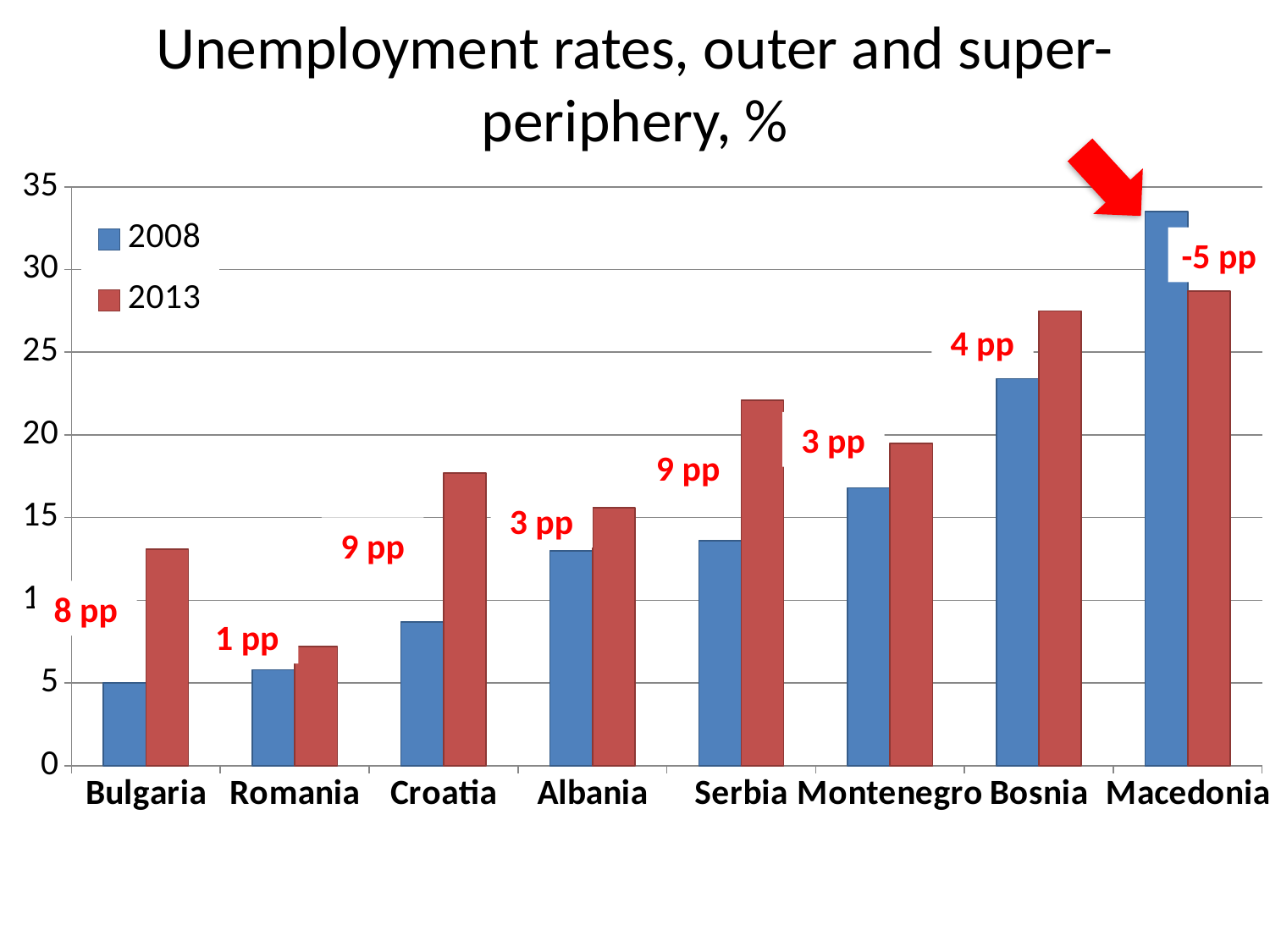
How many series does the legend list? 2 Is the 2008 value for Croatia greater or less than 10? less What kind of chart is shown on the slide? bar chart Is the 2013 value for Bosnia greater or less than 25? greater Is the 2008 value for Macedonia greater or less than 30? greater Which country has the lowest 2013 unemployment rate? Romania How many countries are shown on the x axis? 8 Which country is the only one annotated with a negative change in percentage points? Macedonia Which country has the highest 2008 unemployment rate? Macedonia What is the title of the chart? Unemployment rates, outer and super-periphery, % What change in percentage points is annotated for Croatia? 9 pp Which is larger for Serbia: the 2008 value or the 2013 value? 2013